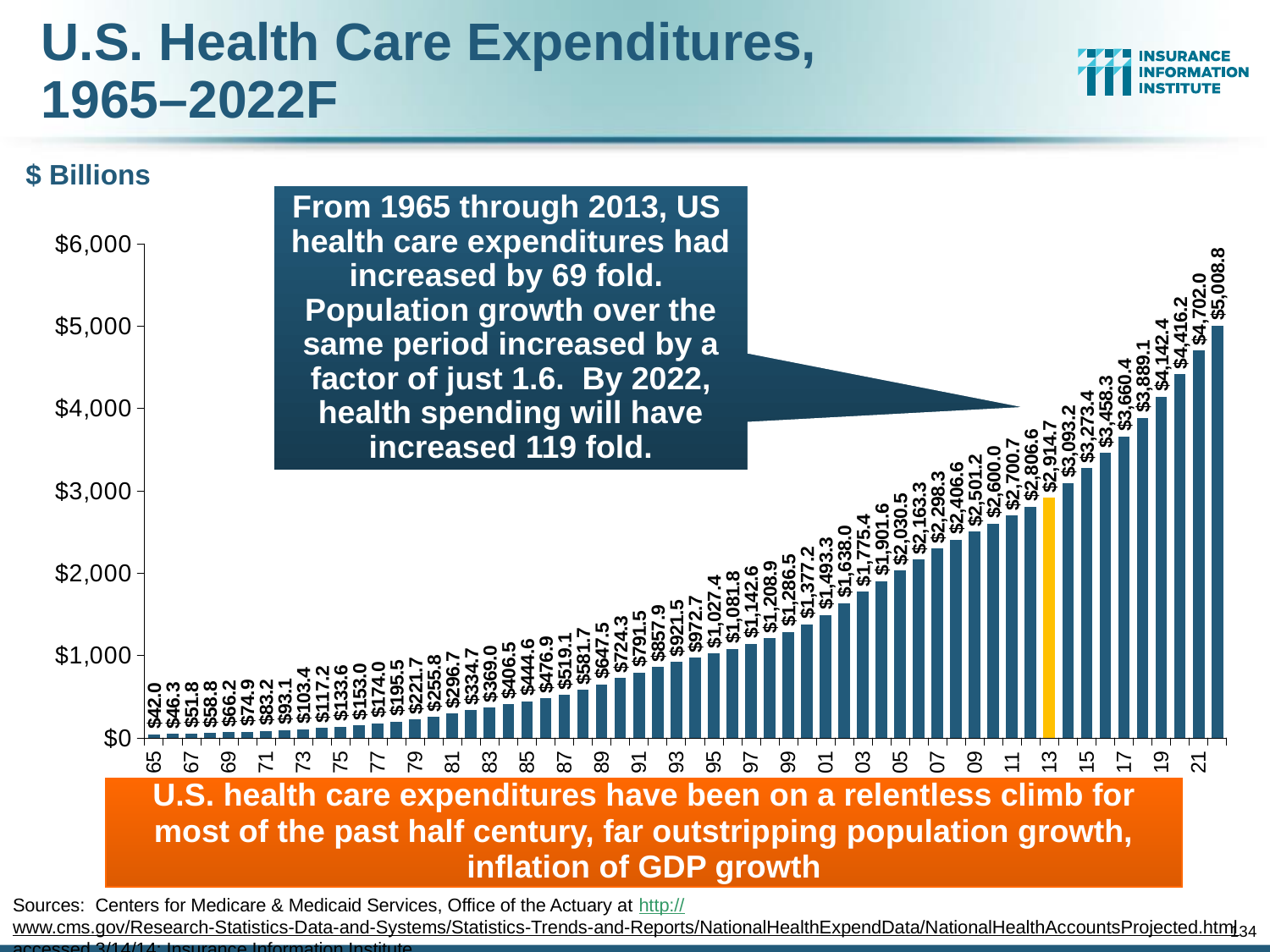
What is the value of the highlighted orange bar for 2013 (labeled 13)? $2,914.7 Which year has the larger value, 2001 (labeled 01) or 1999 (labeled 99)? 2001 What is the lowest value shown on the chart? $42.0 What is the value for 2021 (labeled 21)? $4,702.0 Is the value for 2011 (labeled 11) greater or less than $3,000? less What is the difference between the 2013 value and the 1965 value? $2,872.7 What is the difference between the 2021 value and the 2013 value? $1,787.3 How many bars are plotted on the chart? 58 What is the highest value shown on the chart? $5,008.8 What is the value for 1965 (labeled 65) on the chart? $42.0 Do the values rise or fall from left to right along the x axis? Rise What kind of chart is shown on the slide? Bar chart